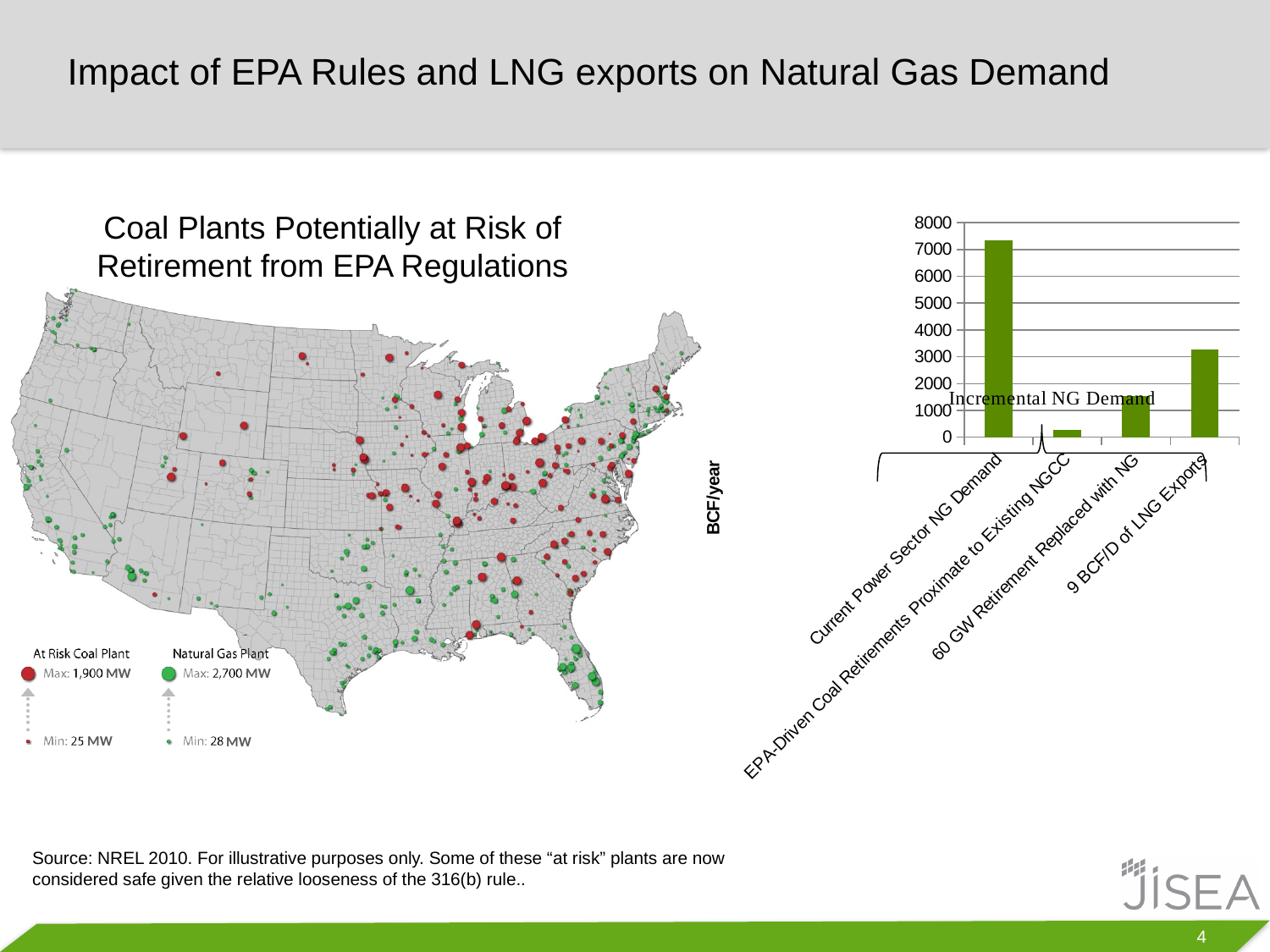
In the bar chart on the right, how many categories are plotted? 4 In the bar chart on the right, which is larger: Current Power Sector NG Demand or 9 BCF/D of LNG Exports? Current Power Sector NG Demand In the bar chart on the right, is the value for 9 BCF/D of LNG Exports greater or less than 3000? greater In the bar chart on the right, which category has the highest value? Current Power Sector NG Demand In the bar chart on the right, is the value for Current Power Sector NG Demand greater or less than 7000? greater In the bar chart on the right, which is larger: 9 BCF/D of LNG Exports or 60 GW Retirement Replaced with NG? 9 BCF/D of LNG Exports What is the highest tick value shown on the vertical axis of the bar chart on the right? 8000 In the bar chart on the right, is the value for 60 GW Retirement Replaced with NG greater or less than 2000? less What kind of chart is shown on the right side of the slide? Bar chart What is the label on the vertical axis of the bar chart on the right? BCF/year In the bar chart on the right, which category has the lowest value? EPA-Driven Coal Retirements Proximate to Existing NGCC